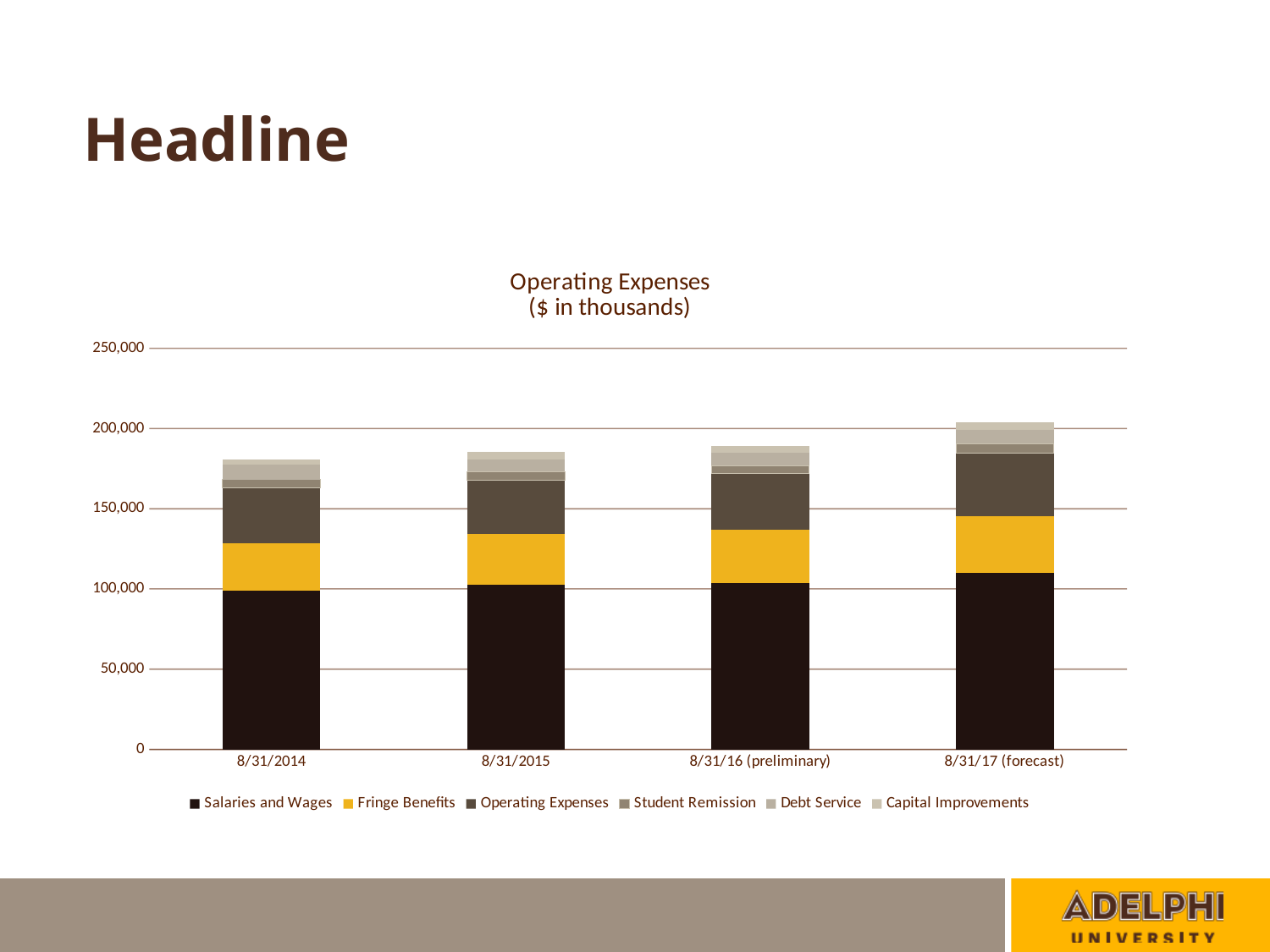
Is the total operating expenses bar for 8/31/2014 greater or less than 200,000? less How many categories (dates) are shown on the x axis of the Operating Expenses chart? 4 Which date has the highest total operating expenses? 8/31/17 (forecast) Is the total operating expenses bar for 8/31/2015 greater or less than 150,000? greater Which is larger, the total operating expenses for 8/31/2014 or for 8/31/17 (forecast)? 8/31/17 (forecast) What is the title of the chart on the slide? Operating Expenses ($ in thousands) Is the Salaries and Wages value for 8/31/17 (forecast) greater or less than 100,000? greater Which series is listed first in the chart legend? Salaries and Wages What kind of chart is shown on the slide? stacked bar chart How many series does the legend of the Operating Expenses chart list? 6 Do the total operating expenses rise or fall from 8/31/2014 to 8/31/17 (forecast)? rise